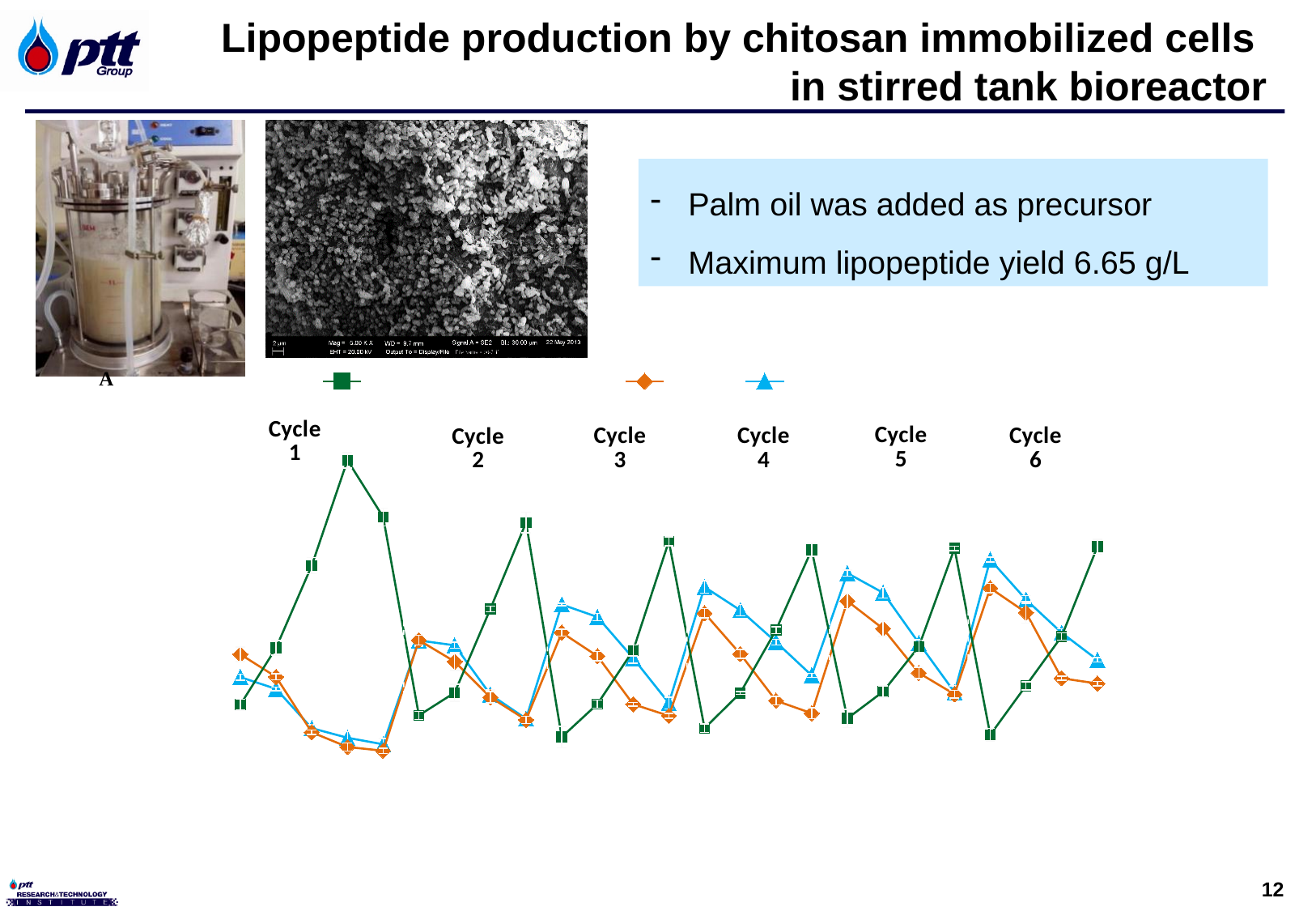
Does the orange series rise or fall from the start of Cycle 1 to its lowest point in Cycle 1? fall What marker shape is used for the blue series in the legend? triangle Does the green series rise or fall from the start of Cycle 1 to its peak in Cycle 1? rise In Cycle 1, which series reaches the higher peak, the green series or the blue series? green In which cycle does the blue series reach its lowest point? Cycle 1 In which cycle does the green series reach its highest point? Cycle 1 In which cycle does the orange series reach its lowest point? Cycle 1 How many series does the chart's legend list? 3 What colours are the three series in the chart? green, orange and blue How many cycles are labelled along the top of the chart? 6 What kind of chart is shown on the slide? line chart